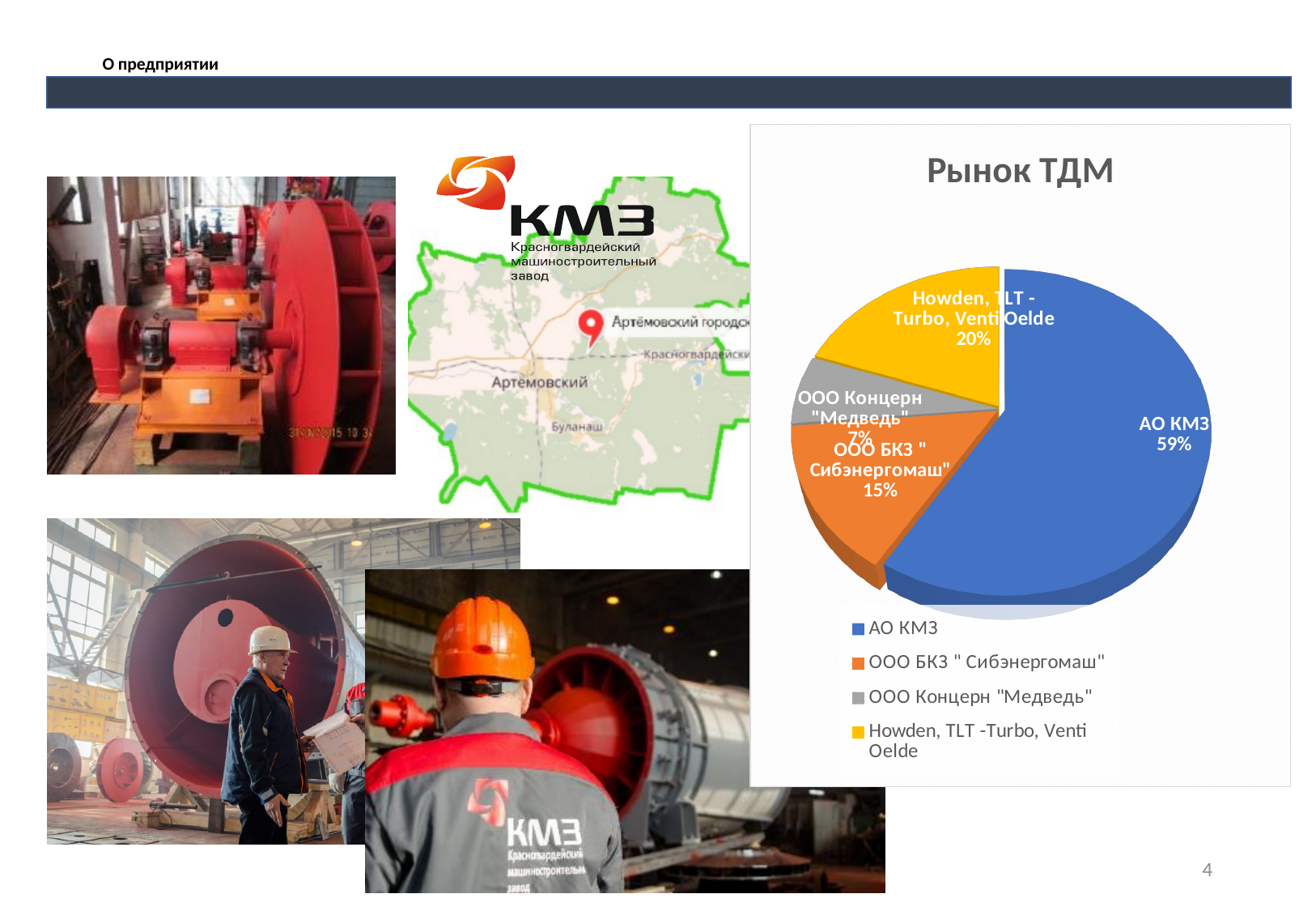
Which is larger: the share of ООО БКЗ "Сибэнергомаш" or the share of Howden, TLT -Turbo, Venti Oelde? Howden, TLT -Turbo, Venti Oelde What is the title of the chart? Рынок ТДМ Which company has the smallest share of the pie? ООО Концерн "Медведь" What share of the pie does ООО БКЗ "Сибэнергомаш" hold? 15% How many slices does the pie chart have? 4 What is the difference in percentage points between the shares of АО КМЗ and Howden, TLT -Turbo, Venti Oelde? 39 Which company has the largest share of the pie? АО КМЗ What kind of chart is shown on the slide? pie chart What colour is the slice for АО КМЗ? blue What share of the pie does ООО Концерн "Медведь" hold? 7% What share of the pie does АО КМЗ hold? 59% What share of the pie does Howden, TLT -Turbo, Venti Oelde hold? 20%